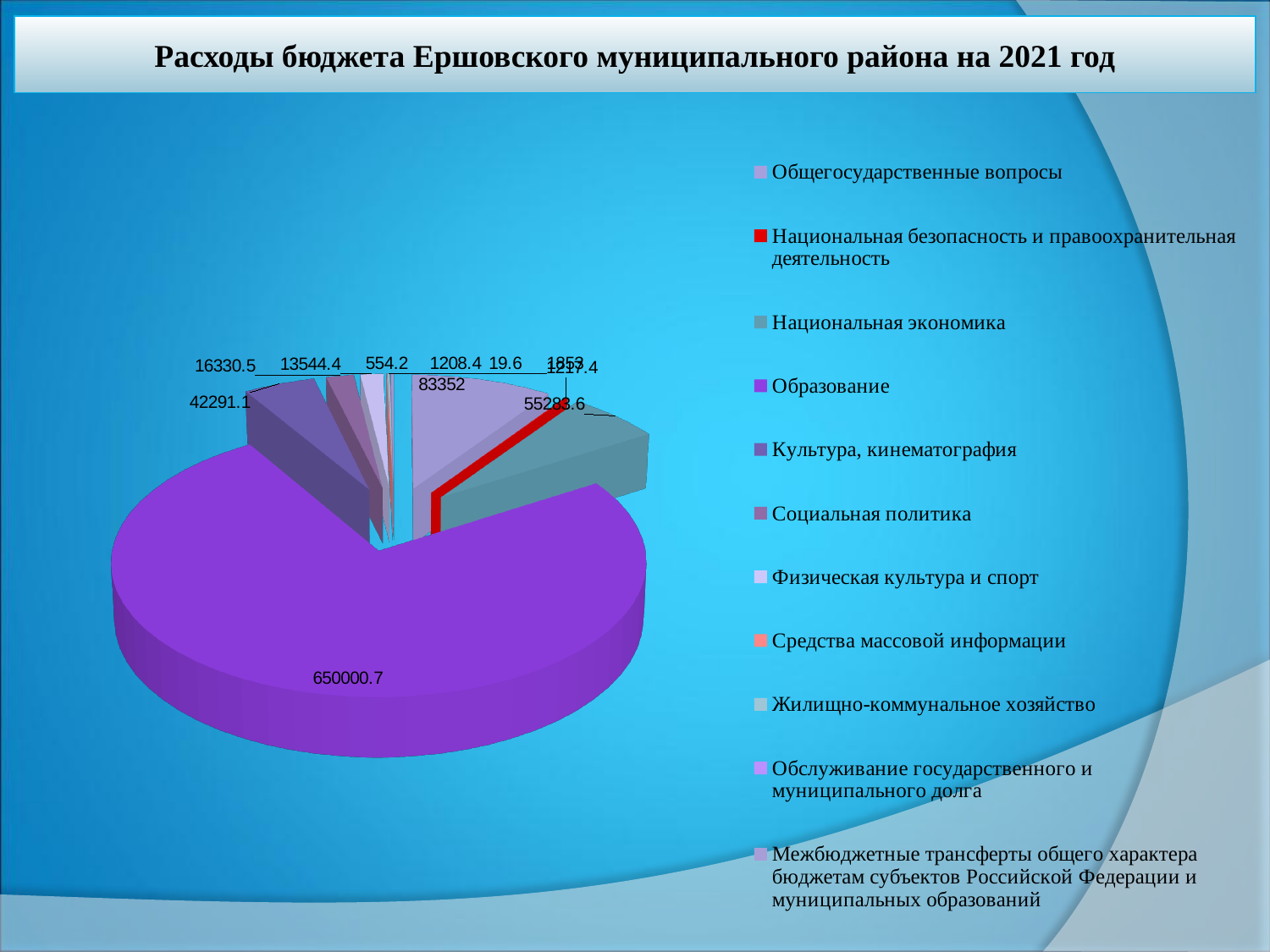
What is the difference between the values for Общегосударственные вопросы and Национальная экономика? 28068.4 Which is larger, Общегосударственные вопросы or Национальная экономика? Общегосударственные вопросы Which category has the smallest value? Обслуживание государственного и муниципального долга How many categories does the legend list? 11 What is the value for Образование? 650000.7 What is the value for Общегосударственные вопросы? 83352 What is the value for Обслуживание государственного и муниципального долга? 19.6 What is the value for Культура, кинематография? 42291.1 What type of chart is shown on the slide? Pie chart Which category has the largest slice of the pie? Образование What is the title of the chart? Расходы бюджета Ершовского муниципального района на 2021 год What is the value for Национальная экономика? 55283.6